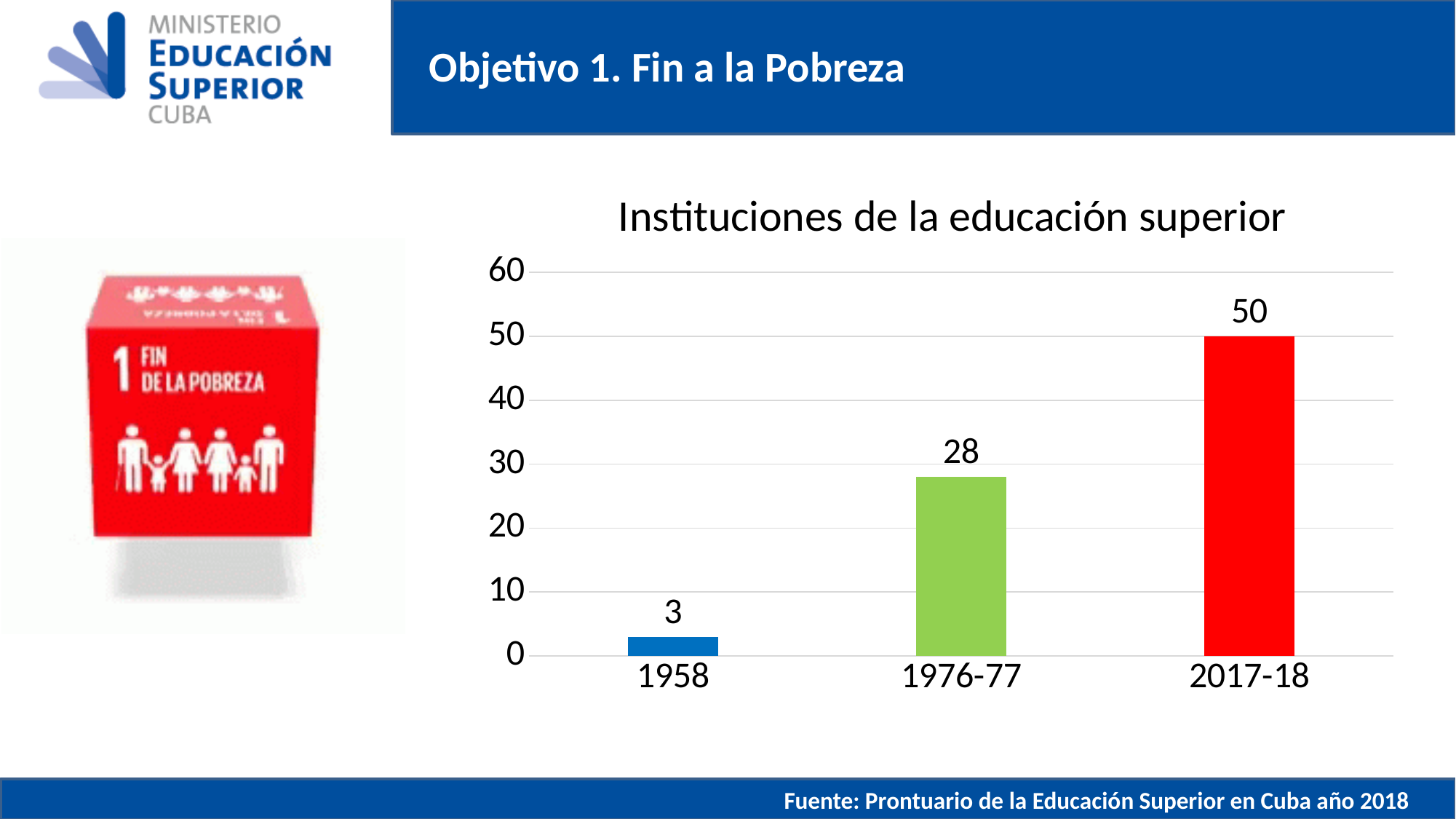
Which category has the lowest value? 1958 What kind of chart is shown on the slide? bar chart Which is larger, the value for 1976-77 or the value for 1958? 1976-77 What is the difference between the values for 1976-77 and 1958? 25 What is the title of the chart? Instituciones de la educación superior What is the difference between the values for 2017-18 and 1976-77? 22 How many categories are shown on the x axis? 3 Is the value for 1976-77 greater or less than 30? less What is the value for 2017-18 in the chart? 50 What is the value for 1958 in the chart? 3 Which category has the highest value? 2017-18 What is the value for 1976-77 in the chart? 28